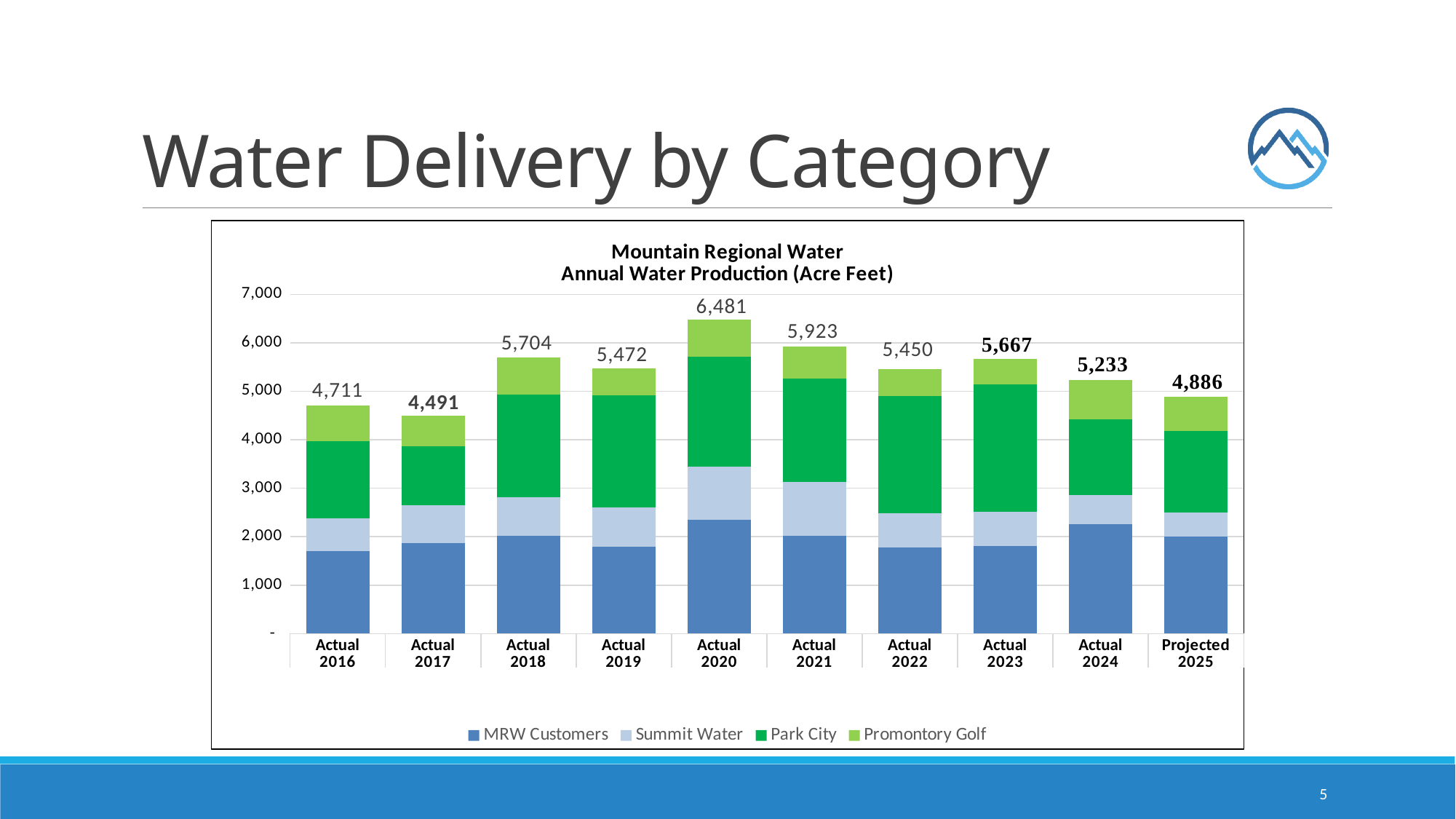
What is the title of the chart? Mountain Regional Water Annual Water Production (Acre Feet) What kind of chart is shown on the slide? Stacked bar chart Do the total values rise or fall from Actual 2023 through Projected 2025? fall What is the total annual water production shown for Actual 2020? 6,481 Which year has the highest total annual water production? Actual 2020 What is the difference between the total for Actual 2020 and the total for Actual 2021? 558 How many series does the legend list? 4 Which is larger, the total for Actual 2018 or the total for Actual 2023? Actual 2018 What is the total value labeled for Projected 2025? 4,886 Is the MRW Customers value for Actual 2020 greater or less than 2,000? greater How many years (bars) are shown on the chart? 10 Which year has the lowest total annual water production? Actual 2017